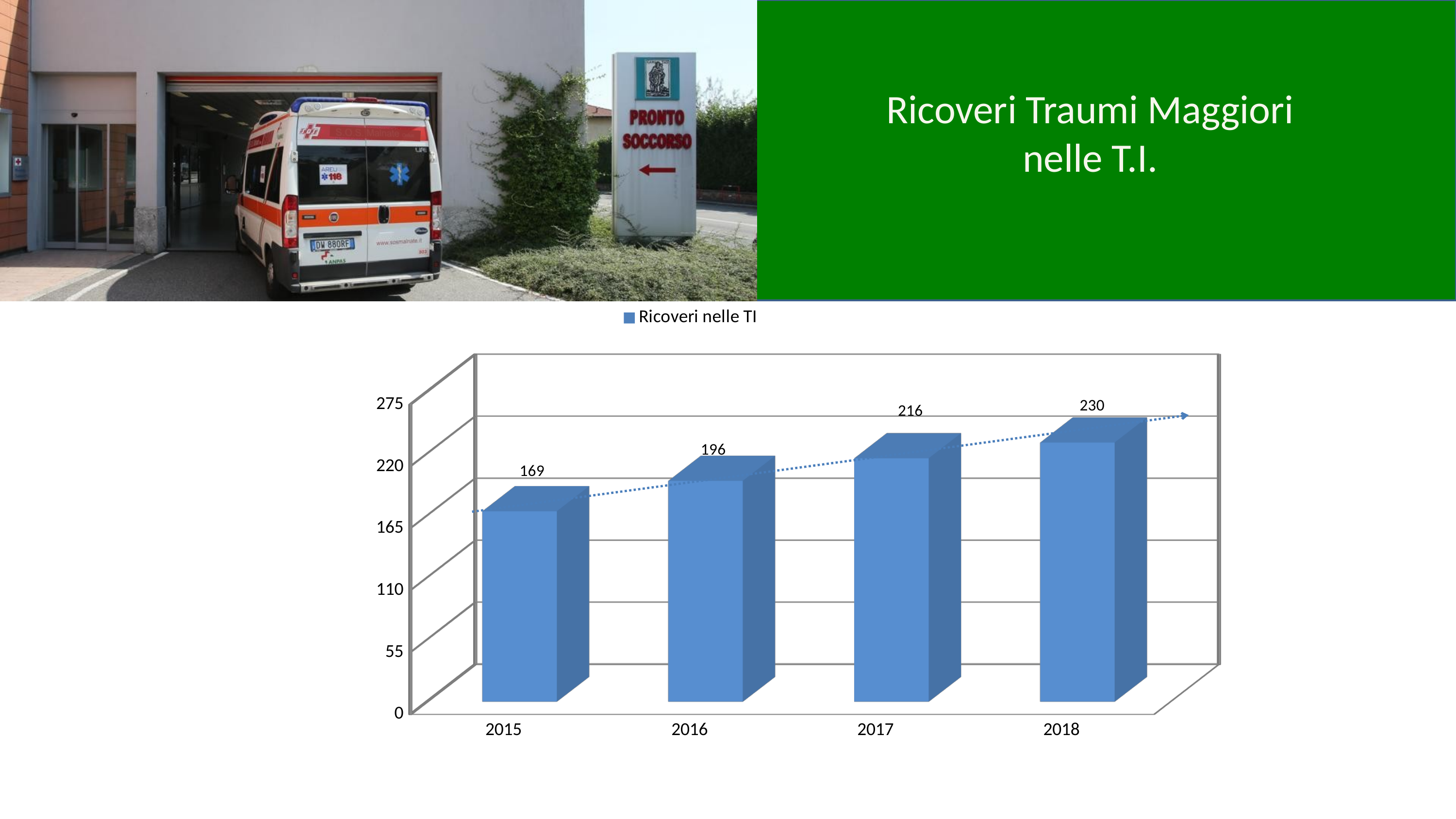
How many series does the legend list? 1 Which year has the highest value? 2018 Do the values rise or fall from 2015 to 2018? rise What kind of chart is shown? bar chart How many years are shown on the x axis? 4 What is the value for 2018? 230 What is the value for 2015? 169 What is the value for 2017? 216 What is the difference between the values for 2018 and 2015? 61 What is the value for 2016? 196 Which is larger, the value for 2016 or the value for 2017? 2017 Which year has the lowest value? 2015